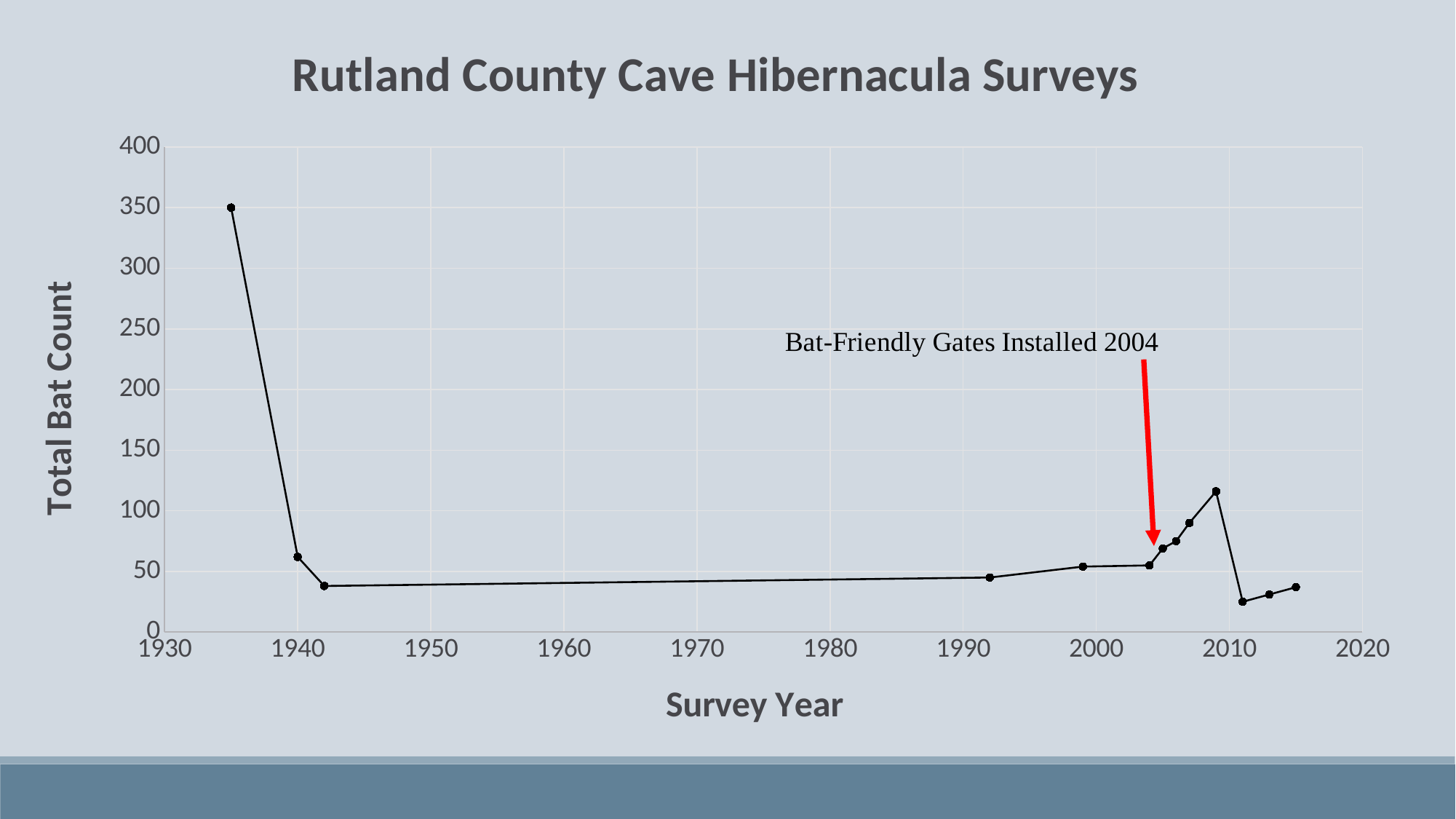
What is the title of the chart? Rutland County Cave Hibernacula Surveys What kind of chart is shown on the slide? line chart What does the annotation with the red arrow on the chart say? Bat-Friendly Gates Installed 2004 Is the total bat count for the survey around 1992 greater or less than 100? less Is the total bat count for the survey around 2011 greater or less than 50? less Does the total bat count rise or fall between the surveys around 2004 and 2009? rise Is the total bat count for the first survey point (around 1935) greater or less than 300? greater Which is larger, the total bat count around 1935 or the total bat count around 2009? 1935 What is the highest value shown on the y axis? 400 Does the total bat count rise or fall between the surveys around 1935 and 1942? fall How many data points are plotted on the line? 13